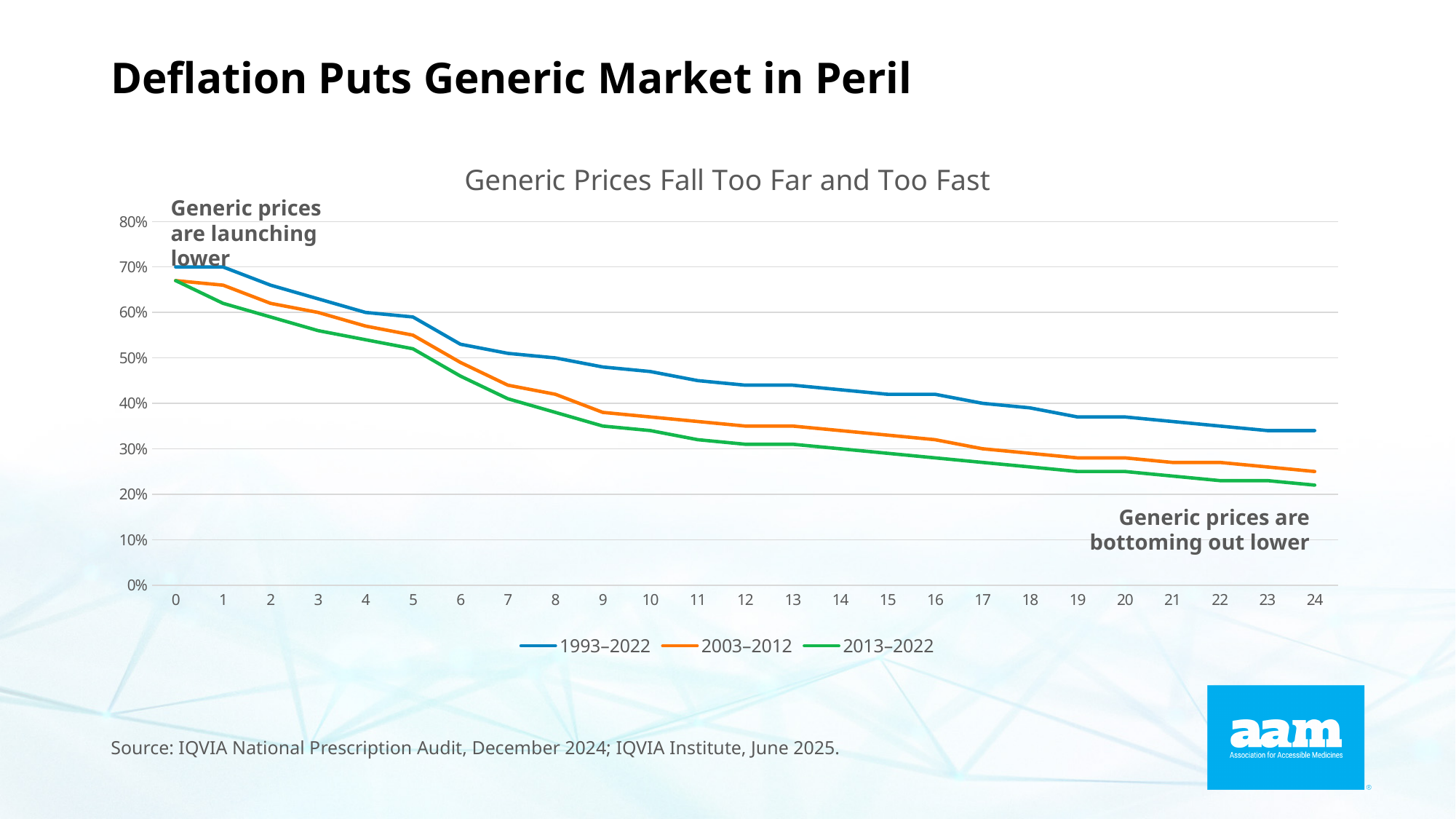
Do the values for the 1993–2022 series rise or fall along the x axis? fall Is the value for 2013–2022 at x = 10 greater or less than 40%? less What kind of chart is shown on the slide? line chart Which series has the lowest value at x = 24? 2013–2022 Is the value for 1993–2022 at x = 24 greater or less than 30%? greater How many series does the legend list? 3 What is the title of the chart? Generic Prices Fall Too Far and Too Fast At x = 24, which is larger: the value for 1993–2022 or the value for 2013–2022? 1993–2022 Is the value for 2003–2012 at x = 0 greater or less than 60%? greater Which series has the highest value at x = 12? 1993–2022 How many points are marked along the x axis? 25